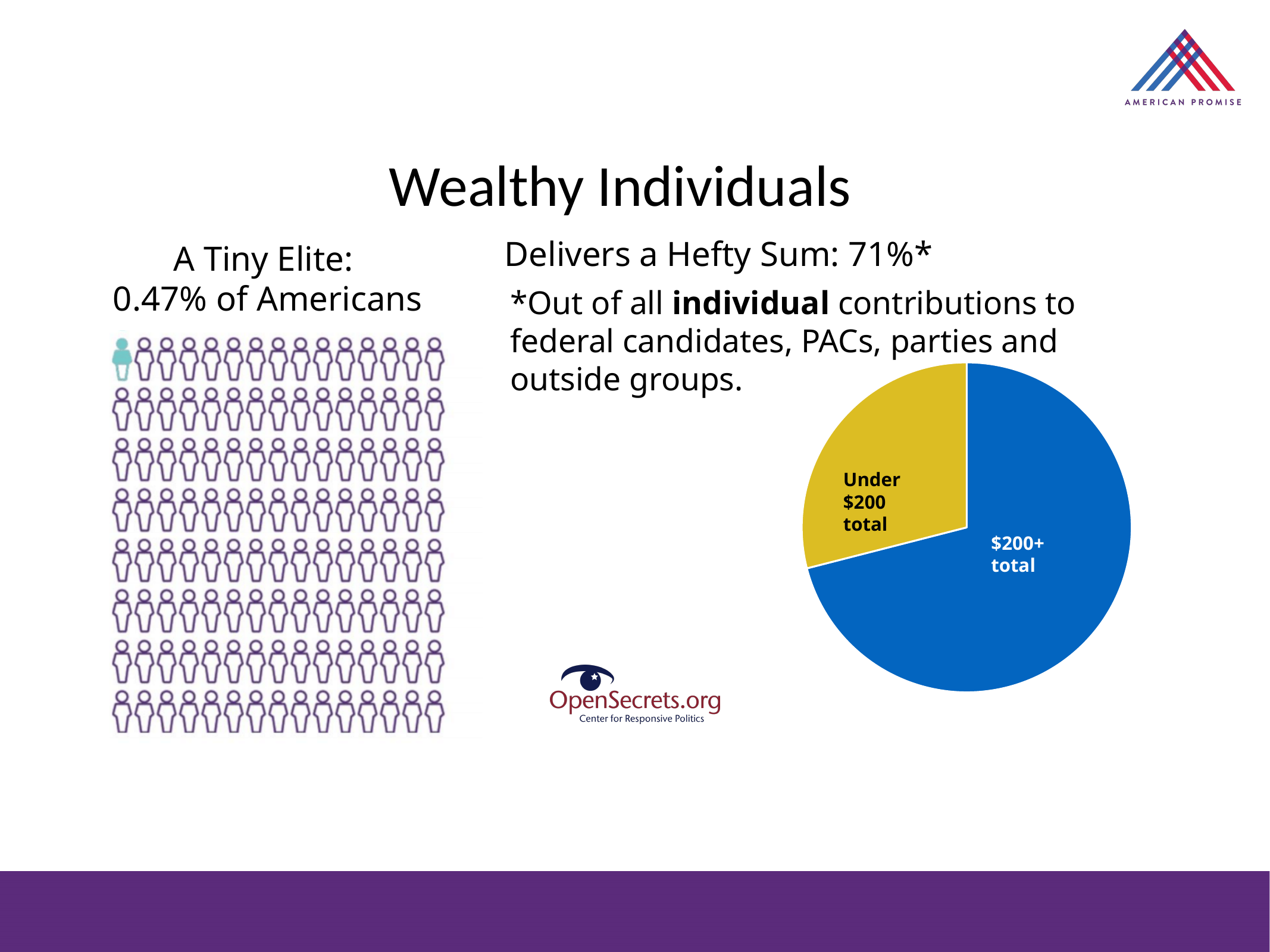
What kind of chart is shown on the right side of the slide? pie chart What colour is the Under $200 total slice in the pie chart? yellow How many slices does the pie chart have? 2 According to the slide, what share of individual contributions does the $200+ total slice represent? 71% In the pie chart, which is larger: the $200+ total slice or the Under $200 total slice? $200+ total Which slice of the pie chart is the smallest? Under $200 total What colour is the $200+ total slice in the pie chart? blue Which slice of the pie chart is the largest? $200+ total